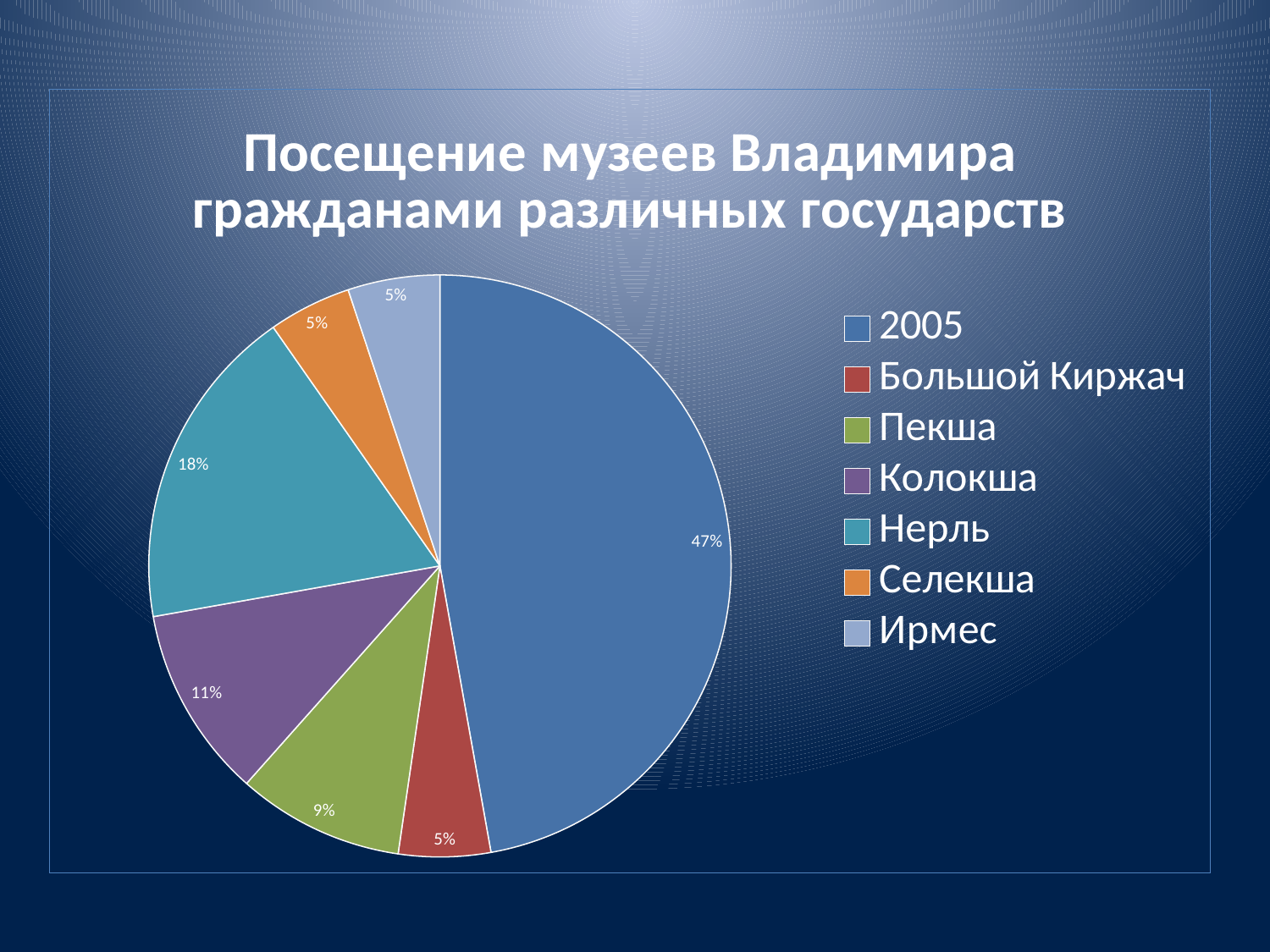
Which legend entry is shown in orange? Селекша Which slice is the largest in the pie chart? 2005 Which is larger, the slice for Нерль or the slice for Колокша? Нерль What kind of chart is shown on the slide? Pie chart What share of the pie does Большой Киржач take? 5% What share of the pie does Пекша take? 9% How many slices does the pie chart have? 7 What share of the pie does the slice labelled 2005 take? 47% What is the title of the chart? Посещение музеев Владимира гражданами различных государств What is the difference between the share for 2005 and the share for Нерль? 29%